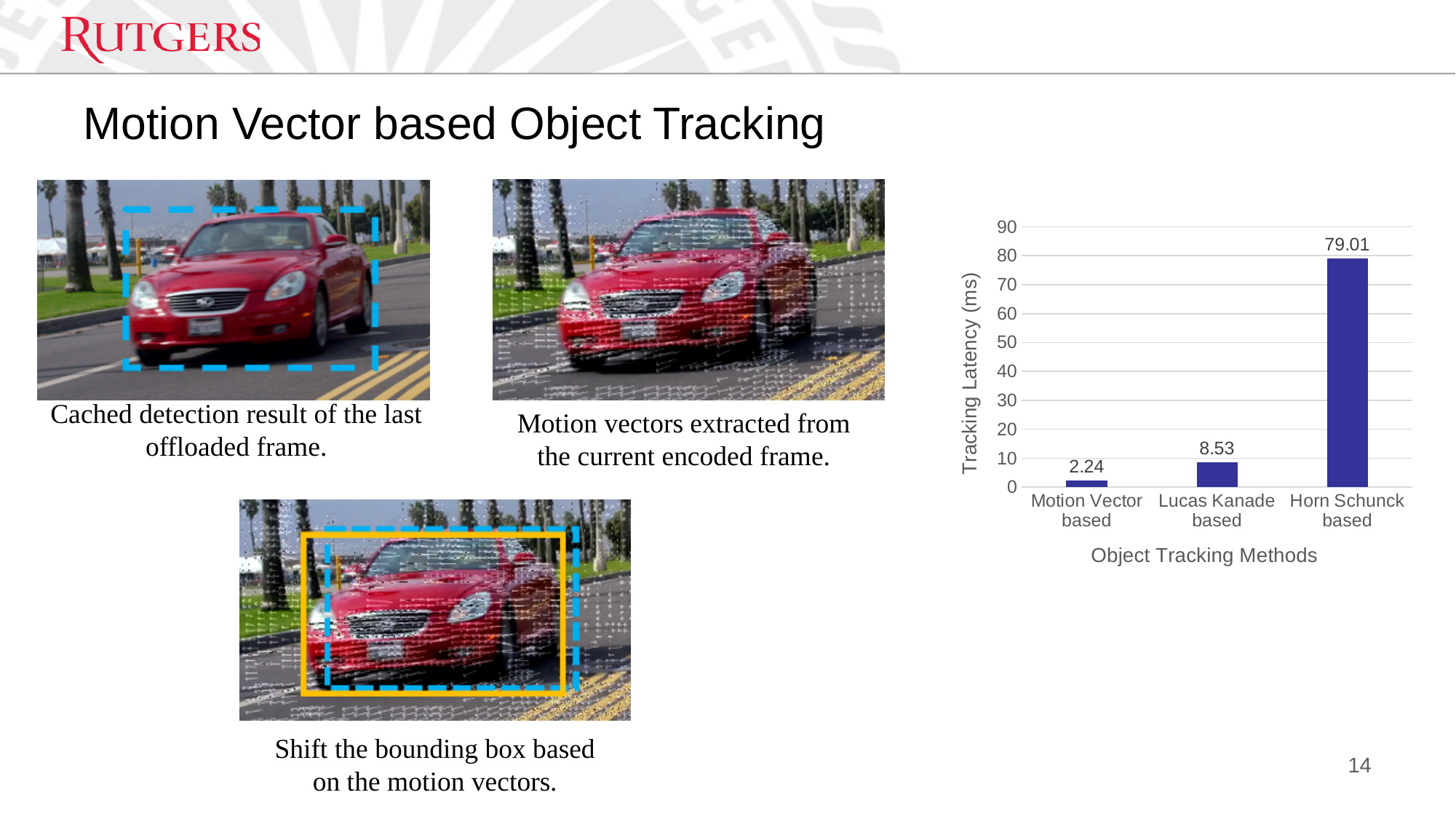
What is the tracking latency for the Horn Schunck based method? 79.01 What is the tracking latency for the Lucas Kanade based method? 8.53 How many object tracking methods are shown in the chart? 3 Is the tracking latency for the Horn Schunck based method greater or less than 70? greater What kind of chart is used to show tracking latency? bar chart What is the label of the vertical axis of the chart? Tracking Latency (ms) What is the difference in tracking latency between the Lucas Kanade based and Motion Vector based methods? 6.29 What is the difference in tracking latency between the Horn Schunck based and Lucas Kanade based methods? 70.48 Which has a larger tracking latency, Lucas Kanade based or Motion Vector based? Lucas Kanade based Which object tracking method has the lowest tracking latency? Motion Vector based What is the tracking latency for the Motion Vector based method? 2.24 Which object tracking method has the highest tracking latency? Horn Schunck based